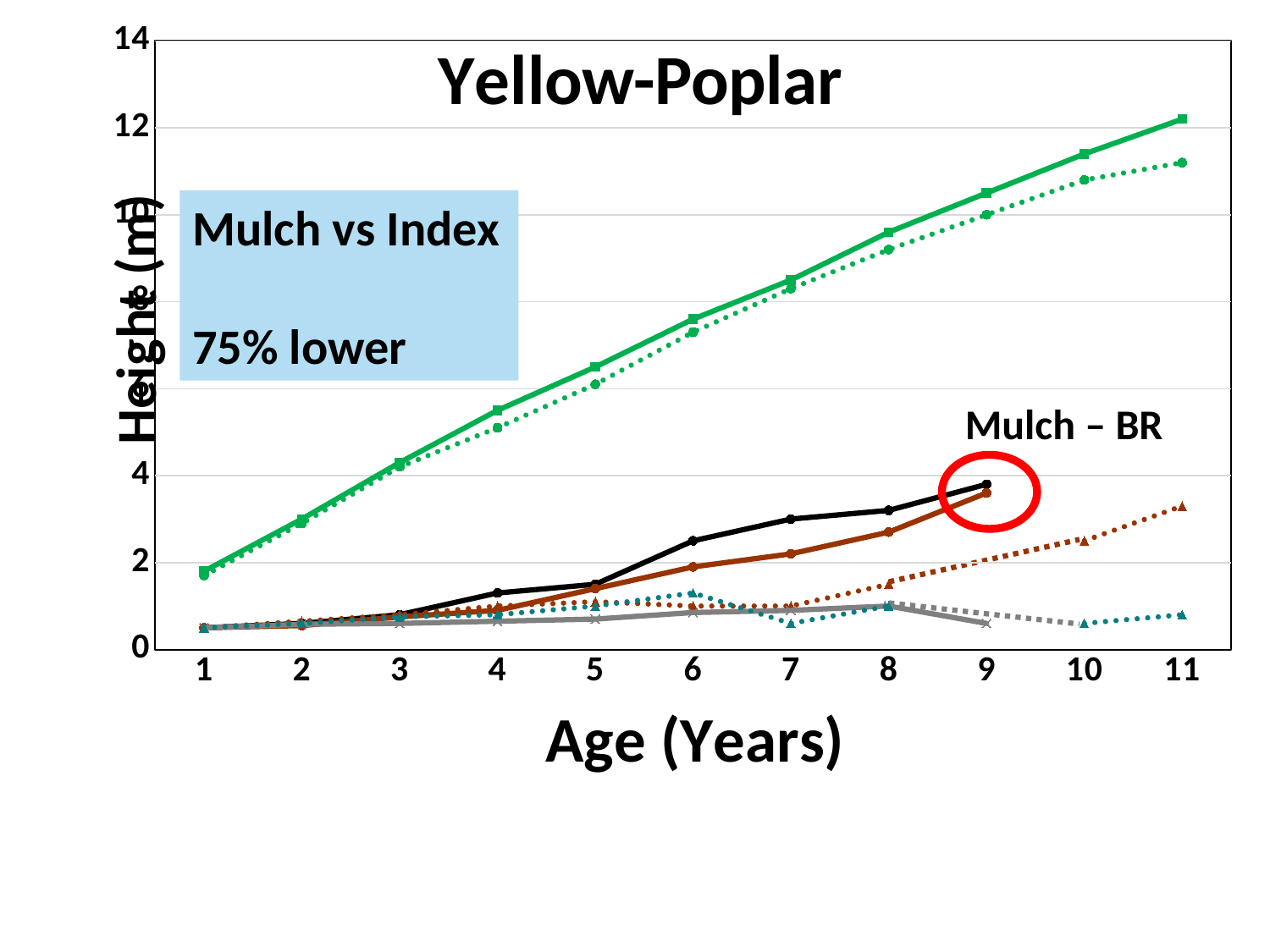
What is the label of the x axis? Age (Years) How many age values are plotted along the x axis? 11 Is the value of the dotted green line at age 11 greater or less than 12? less Is the value of the black line at age 9 greater or less than 2? greater Is the value of the solid green line at age 11 greater or less than 10? greater At age 11, which is higher: the solid green line or the dotted green line? solid green line What is the title of the chart? Yellow-Poplar Does the solid green line rise or fall as age increases from 1 to 11 years? rise What kind of chart is shown on the slide? line chart At age 11, which is higher: the dotted brown line or the dotted teal line? dotted brown line At which age does the solid green line reach its highest value? 11